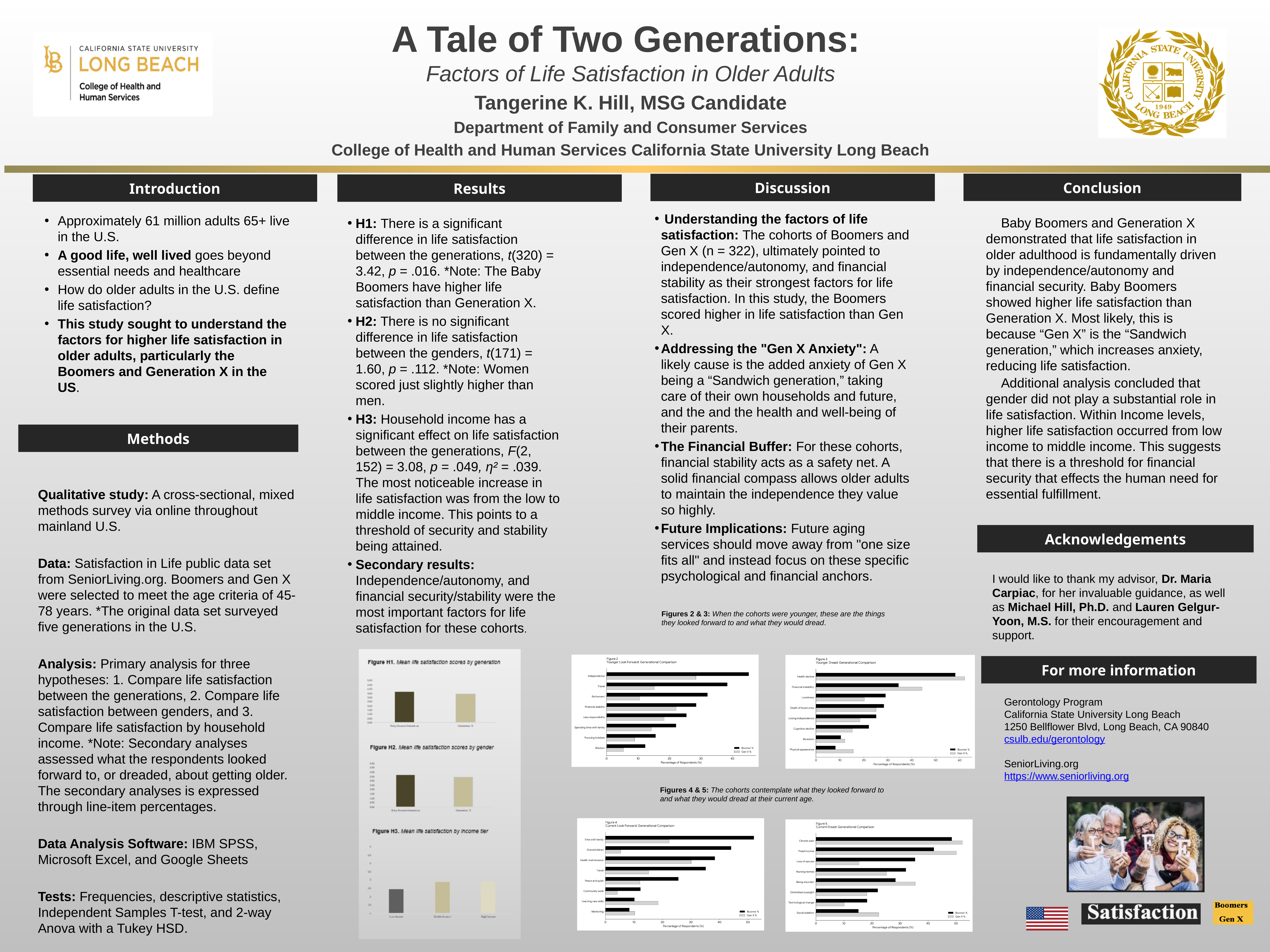
In Figure 4 (Current Look Forward: Generational Comparison), is the Boomer % value for Mentoring greater or less than 10? less In Figure 3 (Younger Dread: Generational Comparison), is the Boomer % value for Health decline greater or less than 50? greater In Figure 3 (Younger Dread: Generational Comparison), which category has the highest Boomer % value? Health decline How many categories are plotted in Figure 2 (Younger Look Forward: Generational Comparison)? 8 What kind of chart is Figure 2 (Younger Look Forward: Generational Comparison)? bar chart How many bars are shown in Figure H3 (Mean life satisfaction by income tier)? 3 In Figure 5 (Current Dread: Generational Comparison), which category has the highest Boomer % value? Chronic pain How many series does the legend of Figure 2 (Younger Look Forward: Generational Comparison) list? 2 In Figure 2 (Younger Look Forward: Generational Comparison), is the Boomer % value for Independence greater or less than 40? greater What are the two legend entries in Figure 5 (Current Dread: Generational Comparison)? Boomer % and Gen X % In Figure 4 (Current Look Forward: Generational Comparison), which category has the highest Boomer % value? Time with family